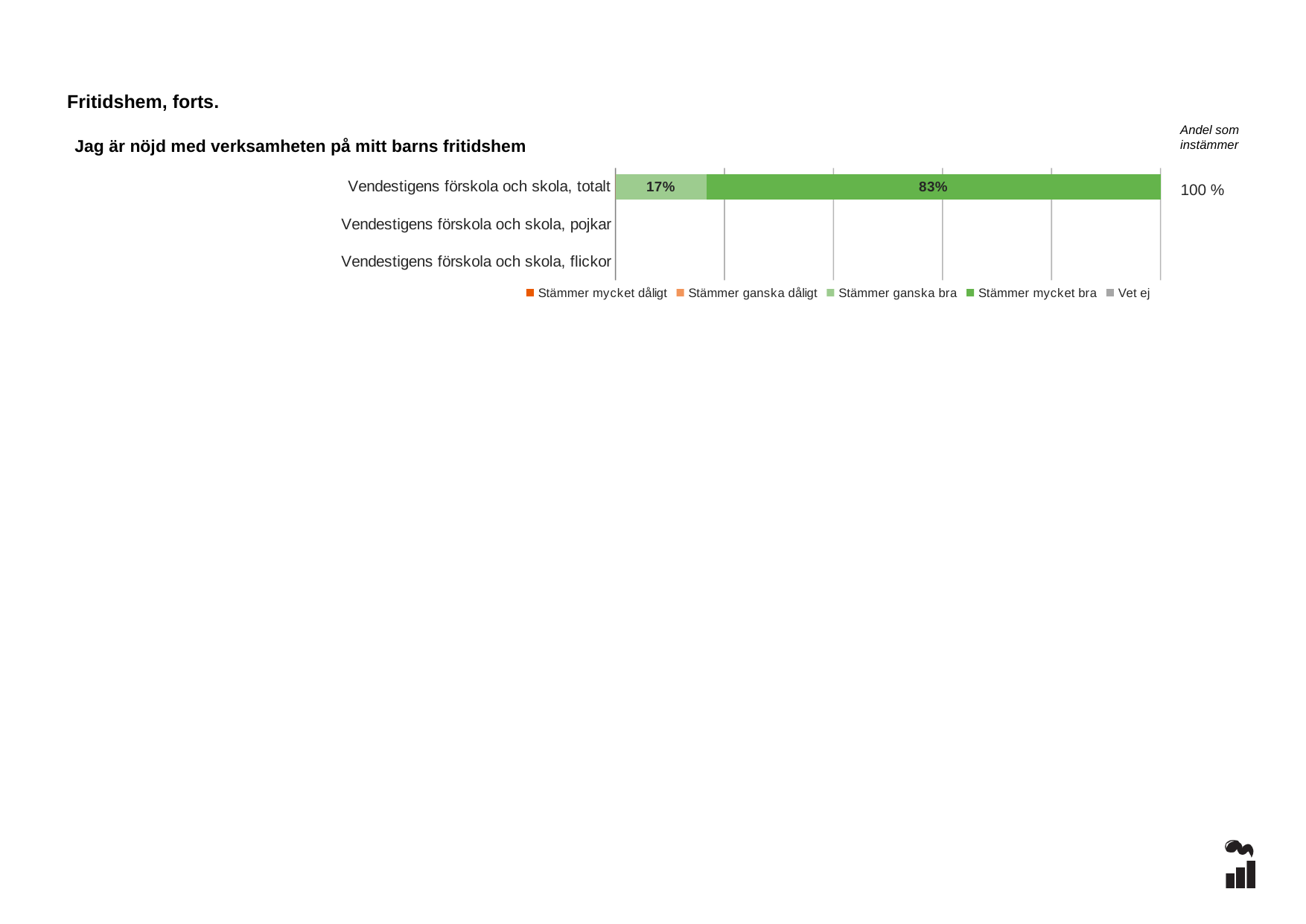
How many series does the legend list? 5 Which is larger for Vendestigens förskola och skola, totalt: "Stämmer ganska bra" or "Stämmer mycket bra"? Stämmer mycket bra How many categories are shown on the vertical axis of the chart? 3 What is the total of the stacked bar for Vendestigens förskola och skola, totalt? 100% What kind of chart is shown on the slide? bar chart What is the value for "Stämmer mycket bra" for Vendestigens förskola och skola, totalt? 83% What is the "Andel som instämmer" value shown for Vendestigens förskola och skola, totalt? 100 % What is the difference between the "Stämmer mycket bra" and "Stämmer ganska bra" values for Vendestigens förskola och skola, totalt? 66% Which legend entry is shown in dark green? Stämmer mycket bra What is the value for "Stämmer ganska bra" for Vendestigens förskola och skola, totalt? 17% Which category has the largest "Stämmer mycket bra" segment? Vendestigens förskola och skola, totalt What is the title of the chart? Jag är nöjd med verksamheten på mitt barns fritidshem